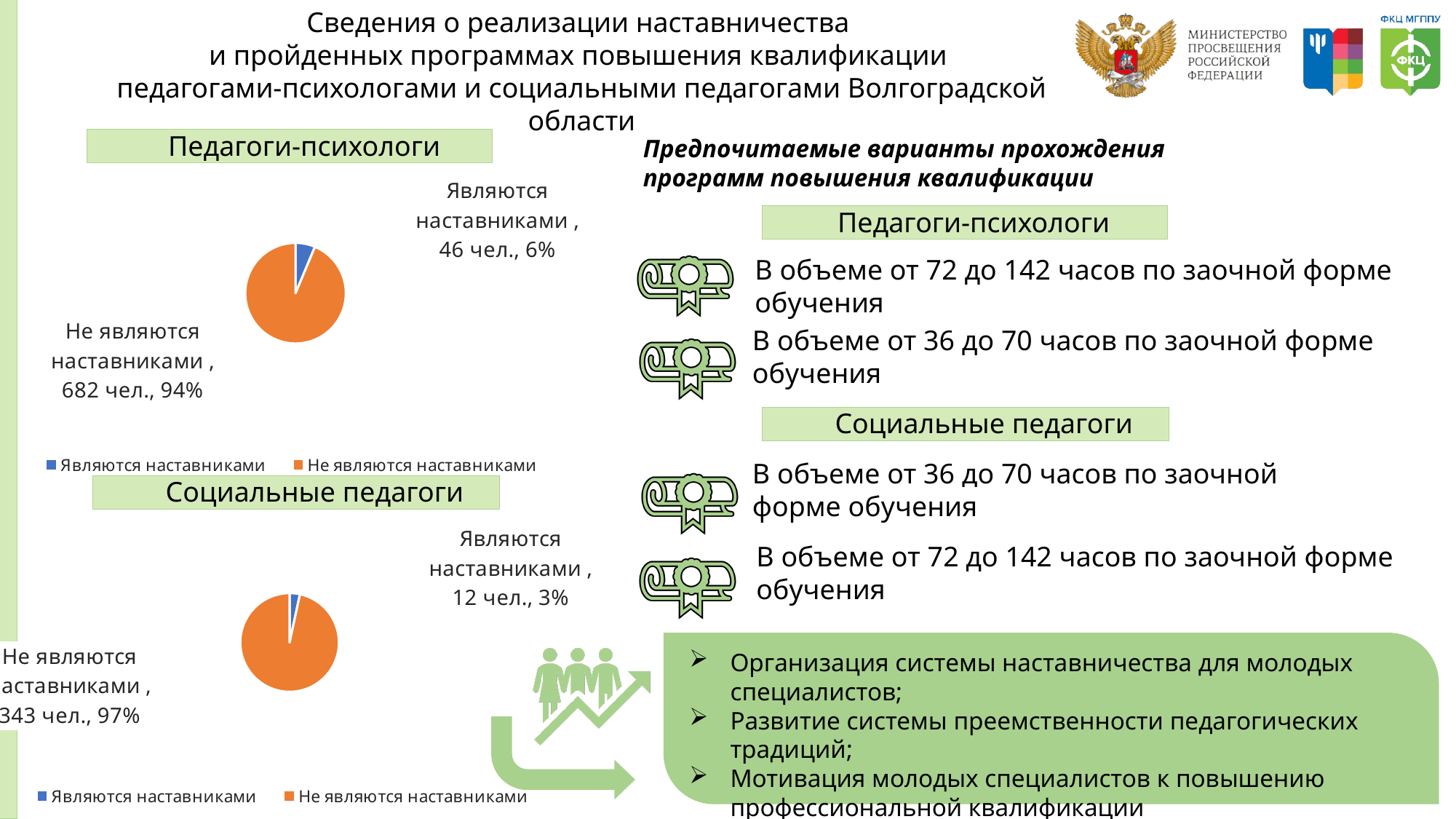
In the "Социальные педагоги" pie chart, which slice is the smallest? Являются наставниками Which colour represents "Являются наставниками" in the legend of the "Педагоги-психологи" pie chart? blue How many slices does the "Социальные педагоги" pie chart have? 2 In the "Социальные педагоги" pie chart, how many people are mentors ("Являются наставниками")? 12 чел. In the "Педагоги-психологи" pie chart, which slice is the largest? Не являются наставниками In the "Педагоги-психологи" pie chart, how many people are not mentors ("Не являются наставниками")? 682 чел. In the "Социальные педагоги" pie chart, what share of the pie is "Не являются наставниками"? 97% What kind of chart is used under the heading "Педагоги-психологи" on the left of the slide? pie chart In the "Социальные педагоги" pie chart, what share of the pie is "Являются наставниками"? 3% In the "Педагоги-психологи" pie chart, what is the difference in people between those who are not mentors and those who are mentors? 636 чел. In the "Педагоги-психологи" pie chart, how many people are mentors ("Являются наставниками")? 46 чел. In the "Педагоги-психологи" pie chart, what share of the pie is "Не являются наставниками"? 94%